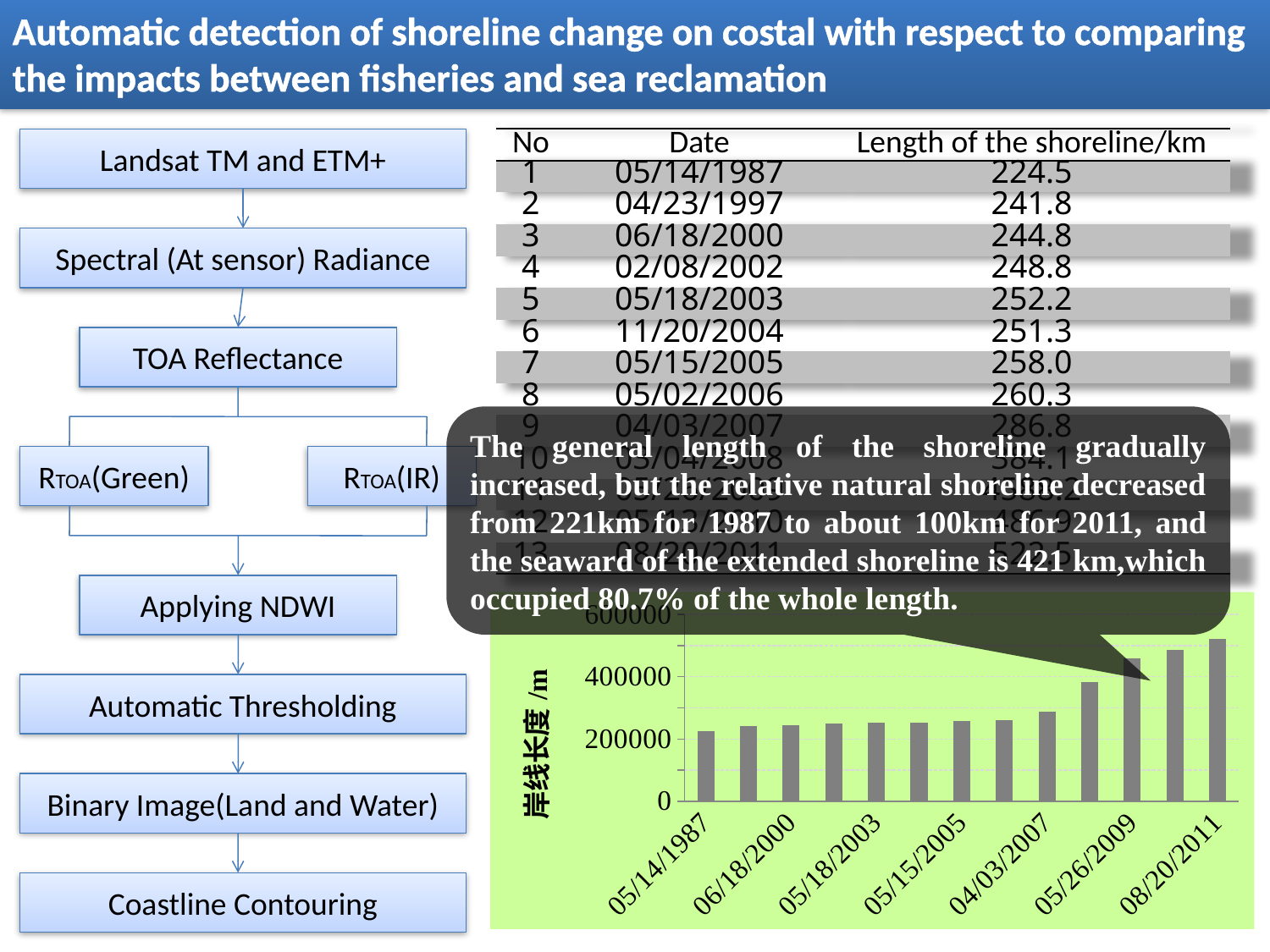
In the bar chart, which is larger, the value for 04/03/2007 or the value for 05/18/2003? 04/03/2007 In the bar chart, is the value for 05/26/2009 greater or less than 400000? greater What is the label on the vertical axis of the bar chart? 岸线长度 /m In the bar chart, which date has the shortest bar? 05/14/1987 In the bar chart, which date has the tallest bar? 08/20/2011 In the bar chart, is the value for 08/20/2011 greater or less than 400000? greater In the bar chart, is the value for 04/03/2007 greater or less than 200000? greater What kind of chart is shown at the bottom right of the slide? bar chart In the bar chart, do the bar heights generally rise or fall from left to right along the x axis? rise In the bar chart, which is larger, the value for 08/20/2011 or the value for 05/14/1987? 08/20/2011 How many bars are plotted in the bar chart at the bottom right? 13